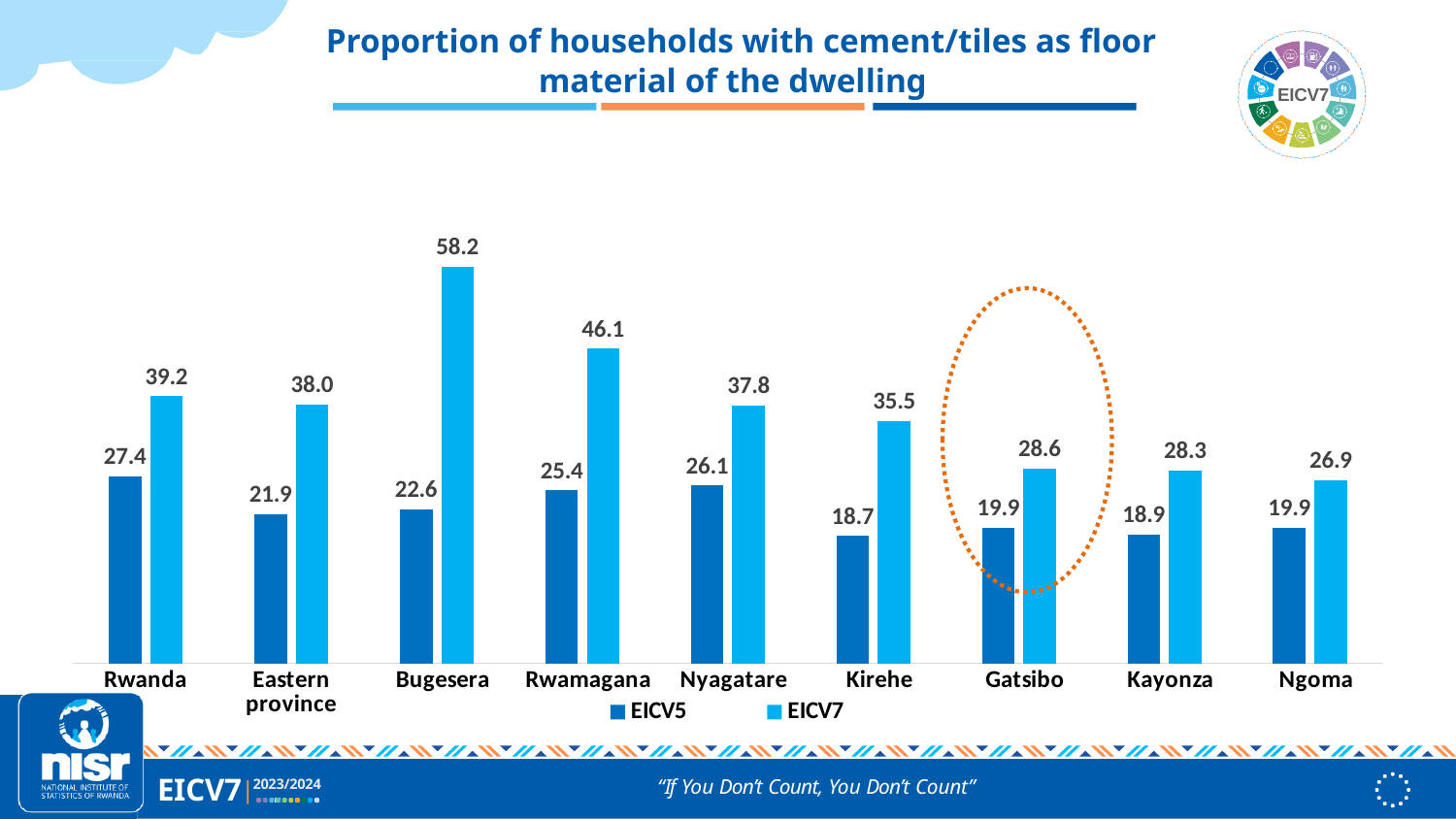
Which is larger, the EICV7 value for Kayonza or the EICV7 value for Ngoma? Kayonza What is the difference between the EICV7 and EICV5 values for Rwamagana? 20.7 What kind of chart is shown on the slide? Bar chart What is the title of the chart? Proportion of households with cement/tiles as floor material of the dwelling Which category has the highest EICV7 value? Bugesera How many categories are shown on the x axis? 9 Which category has the lowest EICV5 value? Kirehe Which category is highlighted with a dotted orange circle? Gatsibo What is the EICV7 value for Rwanda? 39.2 What is the EICV7 value for Bugesera? 58.2 How many series does the legend list? 2 What is the EICV5 value for Gatsibo? 19.9